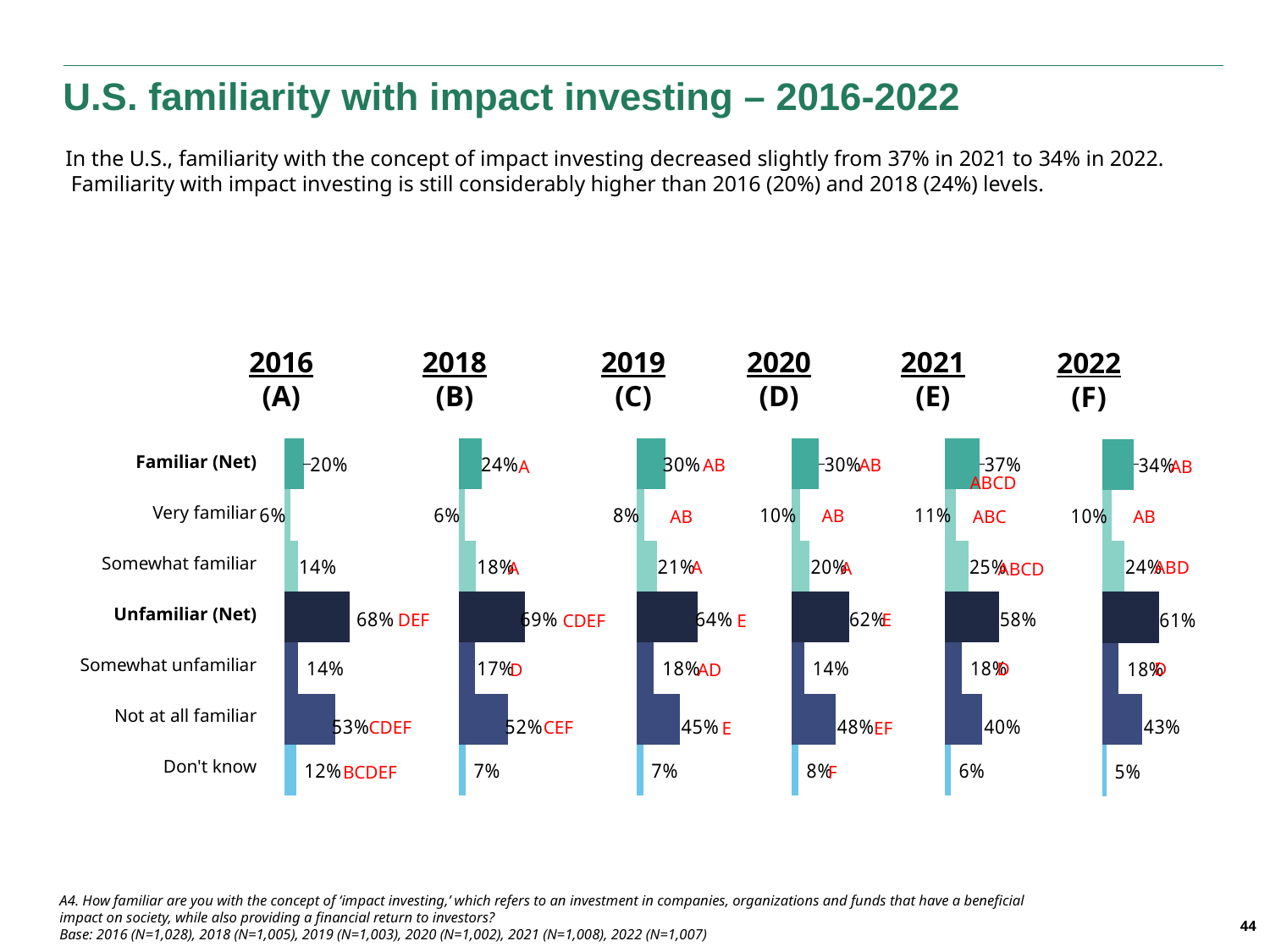
In the 2021 (E) chart, what is the value for Very familiar? 11% What kind of chart is used for each year on this slide? Bar chart In the 2020 (D) chart, which category has the highest value? Unfamiliar (Net) How many categories are shown in each year's chart? 7 In the 2019 (C) chart, what is the value for Don't know? 7% Which is larger: Not at all familiar in the 2019 (C) chart or Not at all familiar in the 2020 (D) chart? 2020 (D) In the 2016 (A) chart, what is the difference between Unfamiliar (Net) and Familiar (Net)? 48% In the 2016 (A) chart, what is the value for Not at all familiar? 53% In the 2022 (F) chart, what is the value for Familiar (Net)? 34% In the 2018 (B) chart, which category has the lowest value? Very familiar What is the difference between the Familiar (Net) value in the 2021 (E) chart and the Familiar (Net) value in the 2022 (F) chart? 3% Across the charts from 2016 to 2021, does the Familiar (Net) value rise or fall? Rise